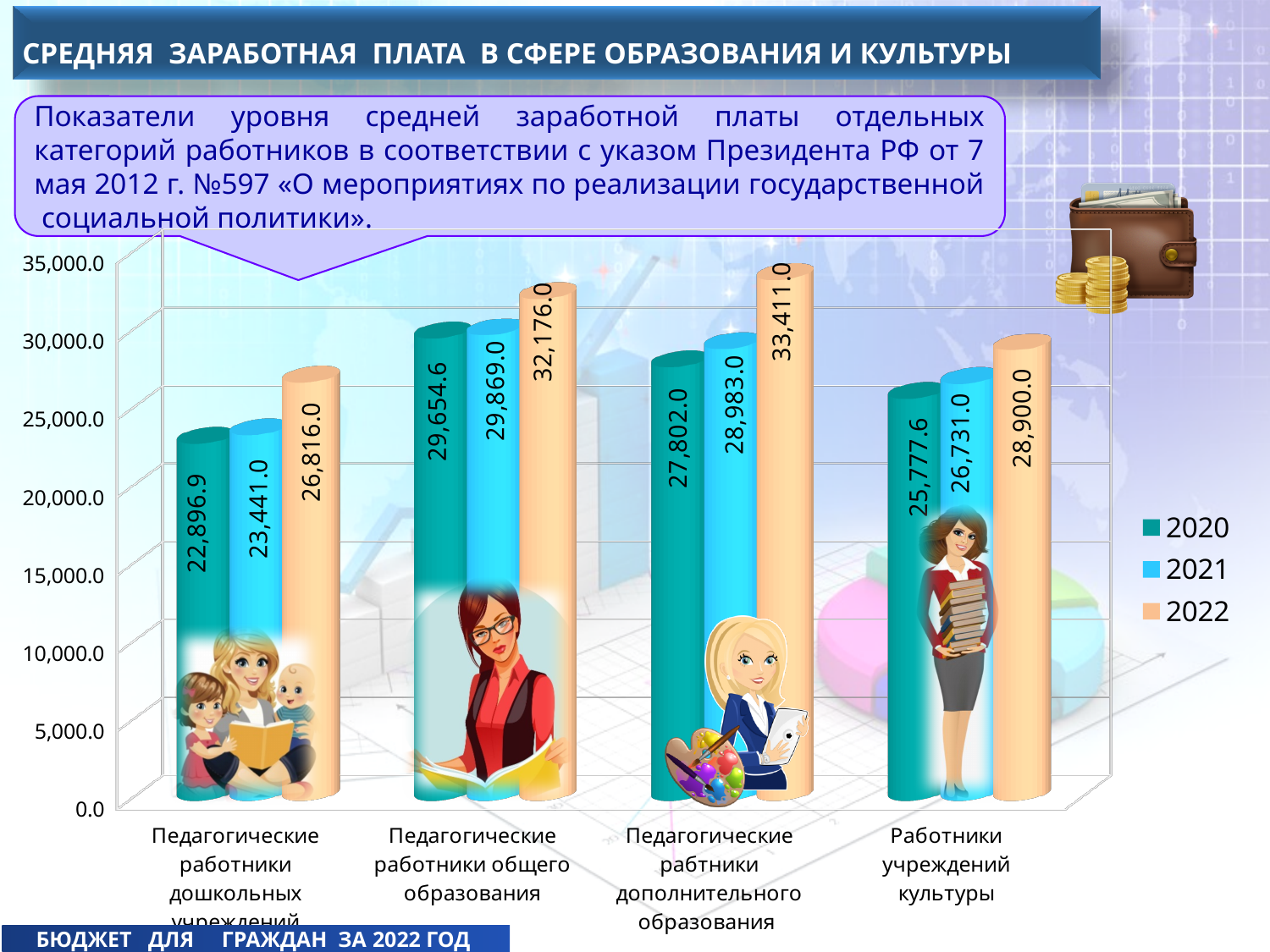
What kind of chart is shown on the slide? bar chart Do the values for Педагогические работники дошкольных учреждений rise or fall from 2020 to 2022? rise How many categories are shown on the x axis? 4 Which category has the highest 2022 value? Педагогические работники дополнительного образования What is the 2020 value for Работники учреждений культуры? 25,777.6 What is the difference between the 2022 and 2020 values for Педагогические работники дополнительного образования? 5,609.0 Which is larger: the 2021 value for Педагогические работники общего образования or the 2021 value for Работники учреждений культуры? Педагогические работники общего образования How many series does the legend list? 3 Is the 2022 value for Работники учреждений культуры greater or less than 30,000.0? less What is the 2022 value for Педагогические работники общего образования? 32,176.0 What is the 2021 value for Педагогические работники дошкольных учреждений? 23,441.0 Which category has the lowest 2020 value? Педагогические работники дошкольных учреждений